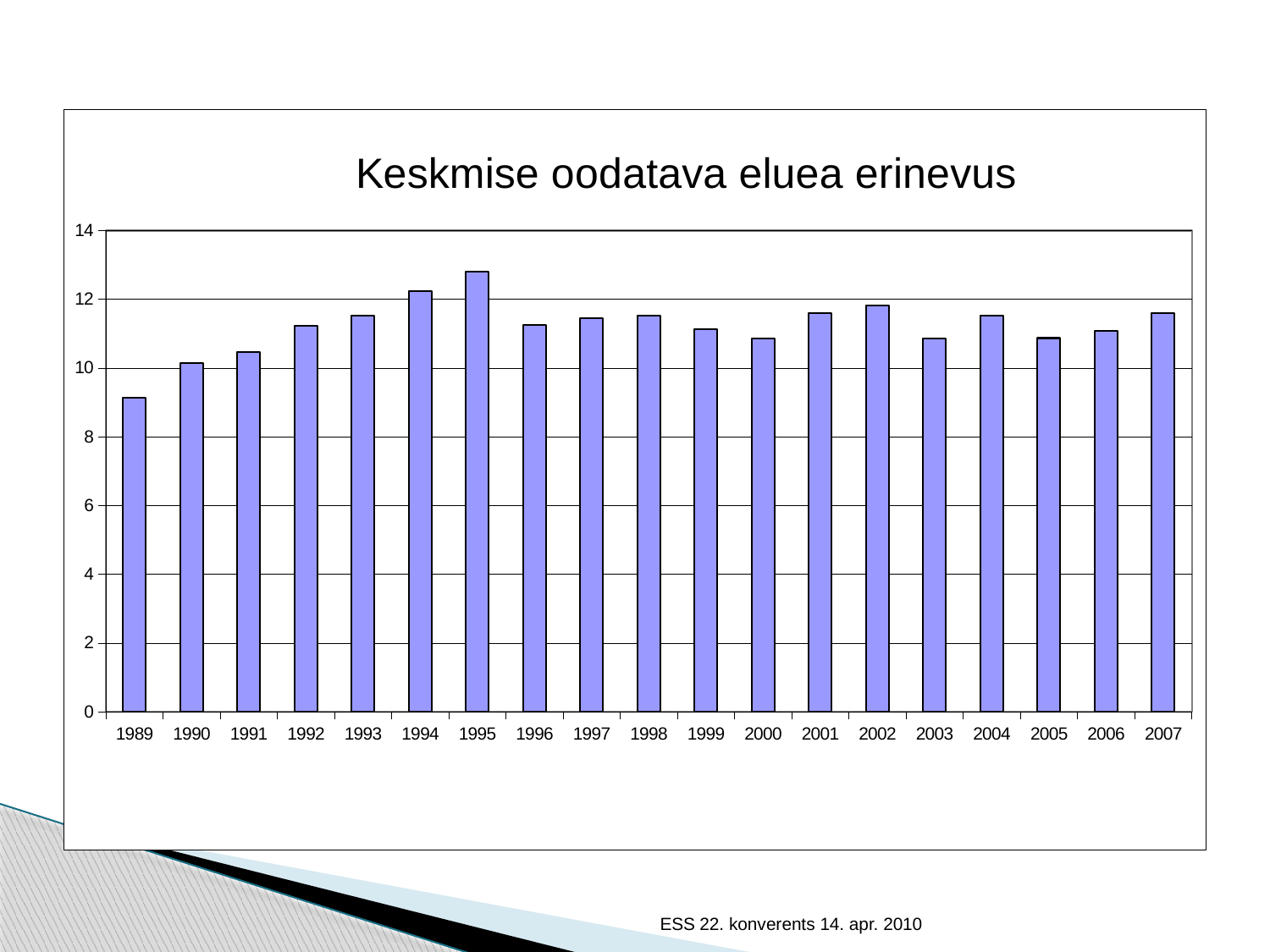
Which year has the lowest bar in the chart? 1989 Is the value for 2000 greater or less than 10? greater Is the value for 1995 greater or less than 12? greater Which year has the larger value, 1989 or 2007? 2007 Which year has the larger value, 1994 or 1990? 1994 How many years (bars) are shown on the x axis of the chart? 19 Is the value for 1994 greater or less than 12? greater Which year has the highest bar in the chart? 1995 What is the title of the chart? Keskmise oodatava eluea erinevus Do the values rise or fall from 1989 to 1995? rise What type of chart is shown on the slide? bar chart